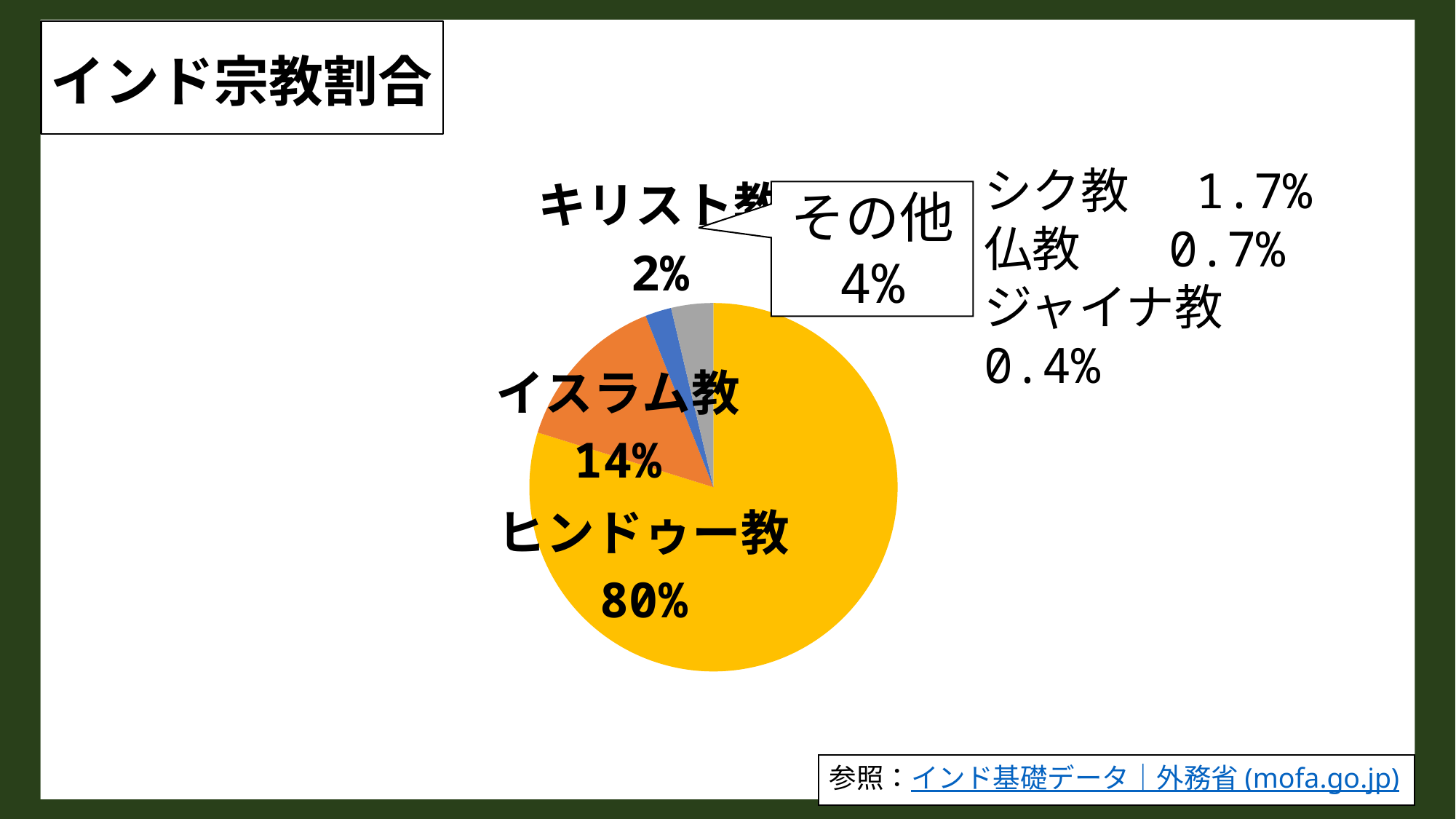
What share of the pie does その他 hold? 4% Which slice of the pie is the largest? ヒンドゥー教 Which slice of the pie is the smallest? キリスト教 What is the title of the slide? インド宗教割合 Which is larger, the share of その他 or the share of キリスト教? その他 What share of the pie does キリスト教 hold? 2% What share of the pie does イスラム教 hold? 14% What colour is the ヒンドゥー教 slice? yellow What is the difference between the shares of ヒンドゥー教 and イスラム教? 66% How many slices does the pie chart have? 4 What share of the pie does ヒンドゥー教 hold? 80% What kind of chart is shown on the slide? pie chart